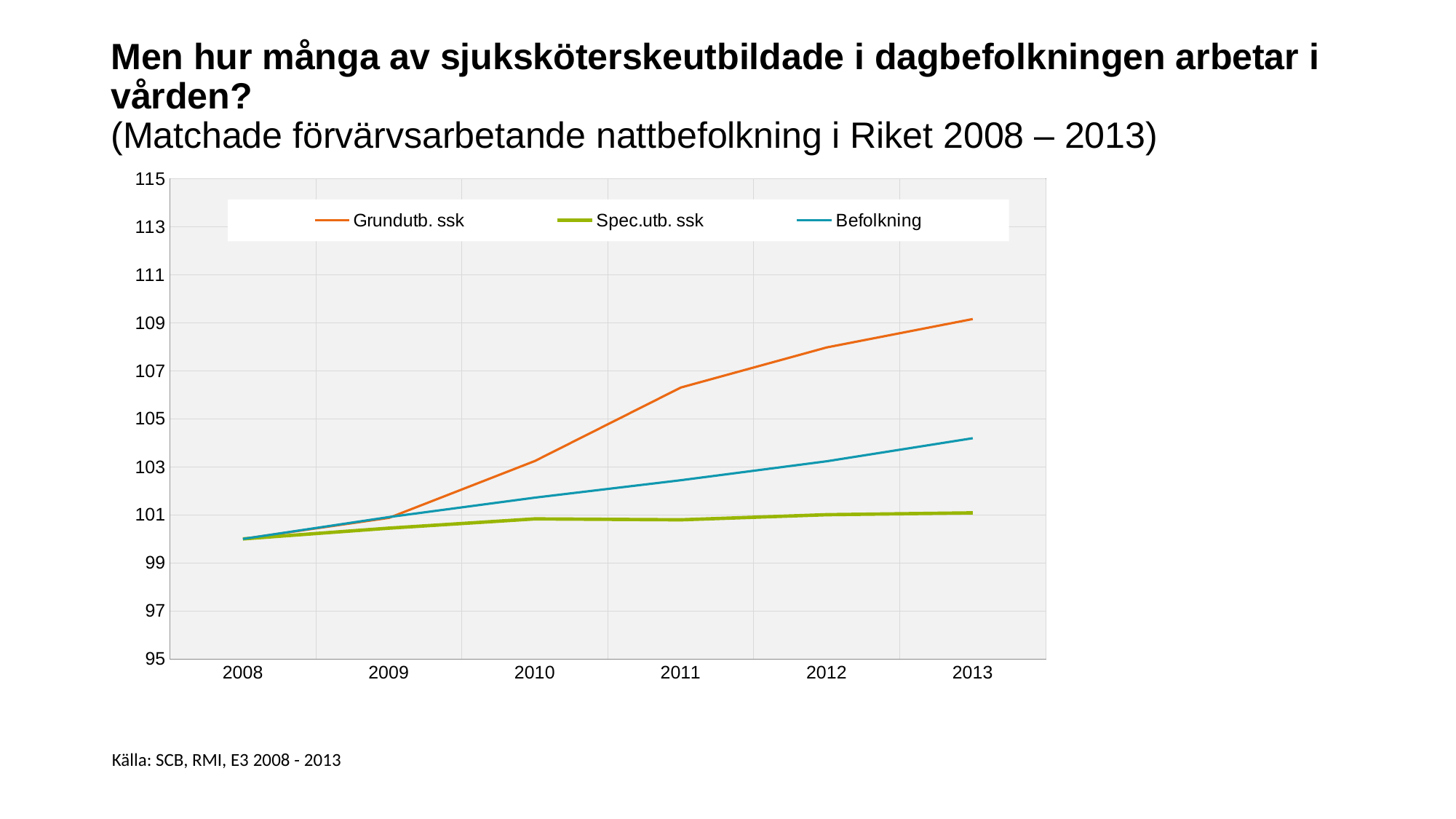
What kind of chart is shown on the slide? line chart Is the value for Spec.utb. ssk in 2013 greater or less than 103? less Is the value for Grundutb. ssk in 2013 greater or less than 107? greater Which series has the lowest value in 2013? Spec.utb. ssk What colour is the Grundutb. ssk line? orange Does the Grundutb. ssk line rise or fall from 2008 to 2013? rise In 2012, which is larger: Befolkning or Spec.utb. ssk? Befolkning Which series has the highest value in 2013? Grundutb. ssk Is the value for Grundutb. ssk in 2011 greater or less than 107? less How many years are plotted along the x axis? 6 How many series does the legend list? 3